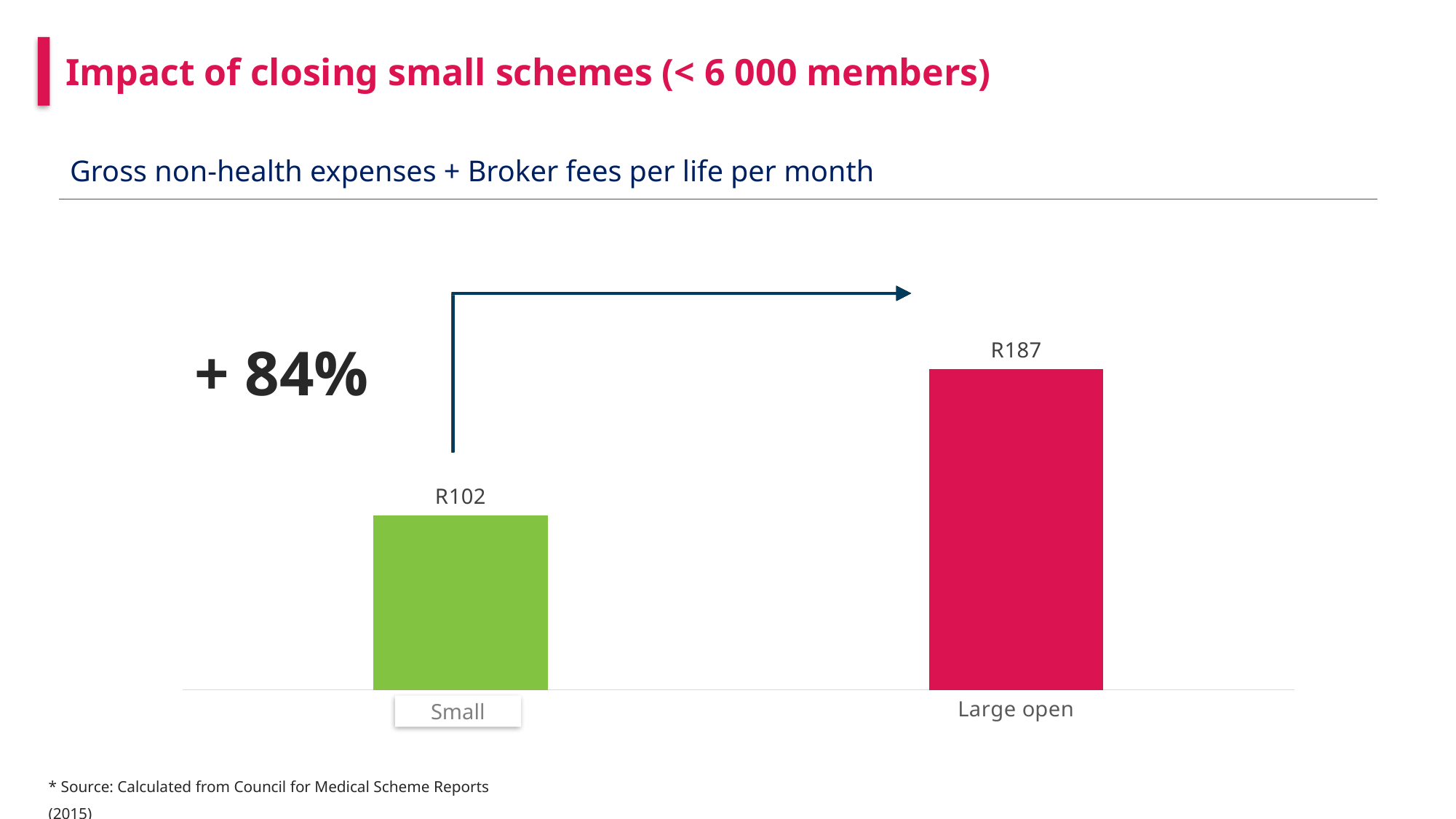
What is the value for Large open? R187 Which is larger, the value for Small or the value for Large open? Large open How many categories are shown in the chart? 2 Which category has the highest value? Large open What percentage increase is annotated between the Small and Large open bars? + 84% What is the value for Small? R102 Which category has the lowest value? Small What kind of chart is shown on the slide? Bar chart What is the title of the chart? Gross non-health expenses + Broker fees per life per month What is the difference between the values for Large open and Small? R85 Do the values rise or fall from Small to Large open? Rise